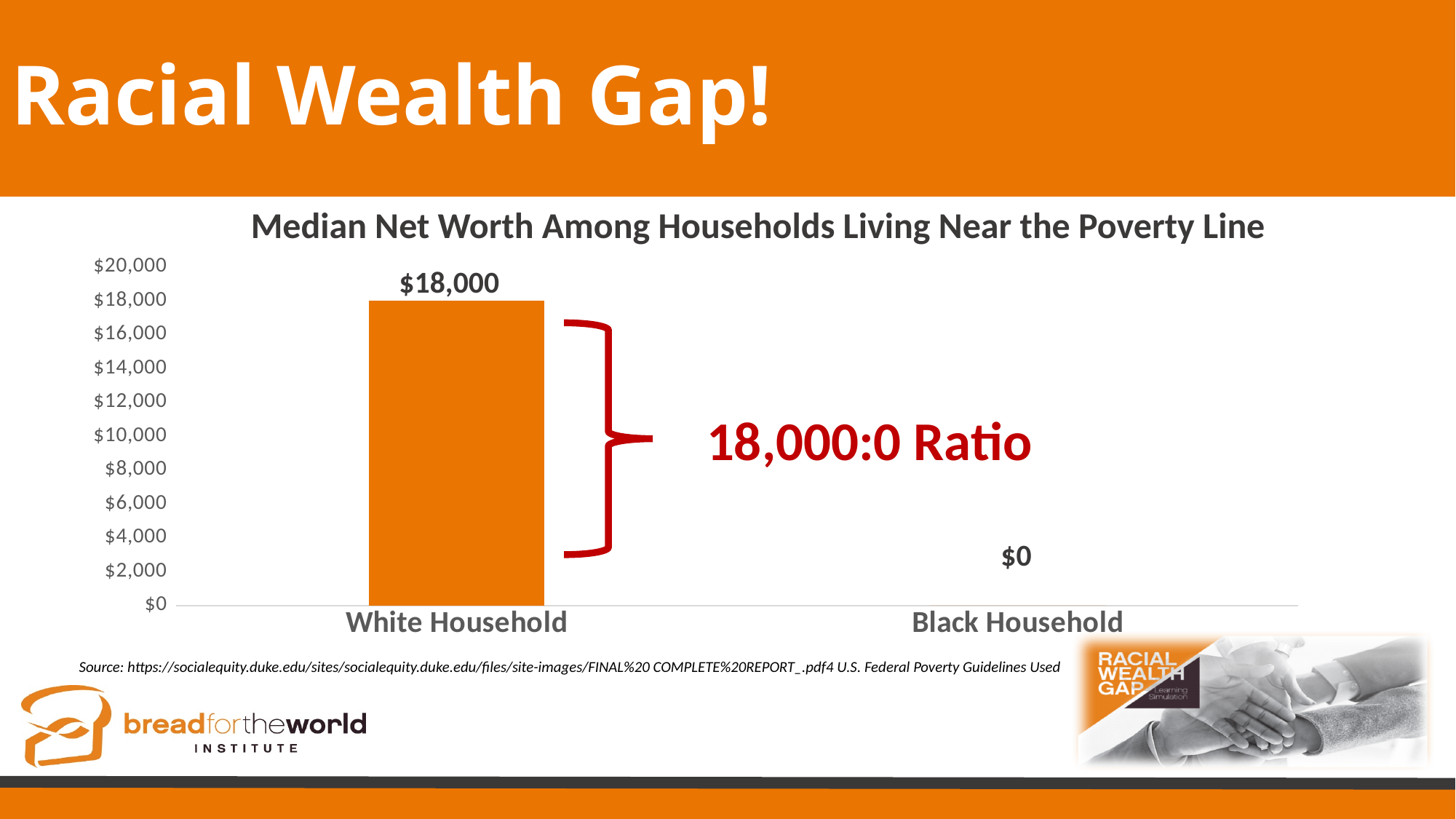
What is the difference between the median net worth of White Household and Black Household? $18,000 What is the median net worth shown for White Household? $18,000 How many categories are shown on the x axis? 2 Which category has the highest median net worth? White Household What is the title of the chart? Median Net Worth Among Households Living Near the Poverty Line What kind of chart is shown on the slide? bar chart Which category has the lowest median net worth? Black Household What is the median net worth shown for Black Household? $0 Is the value for White Household greater or less than $10,000? greater What is the highest value shown on the y axis? $20,000 What ratio is written in red next to the chart? 18,000:0 Ratio Which is larger, the median net worth for White Household or for Black Household? White Household